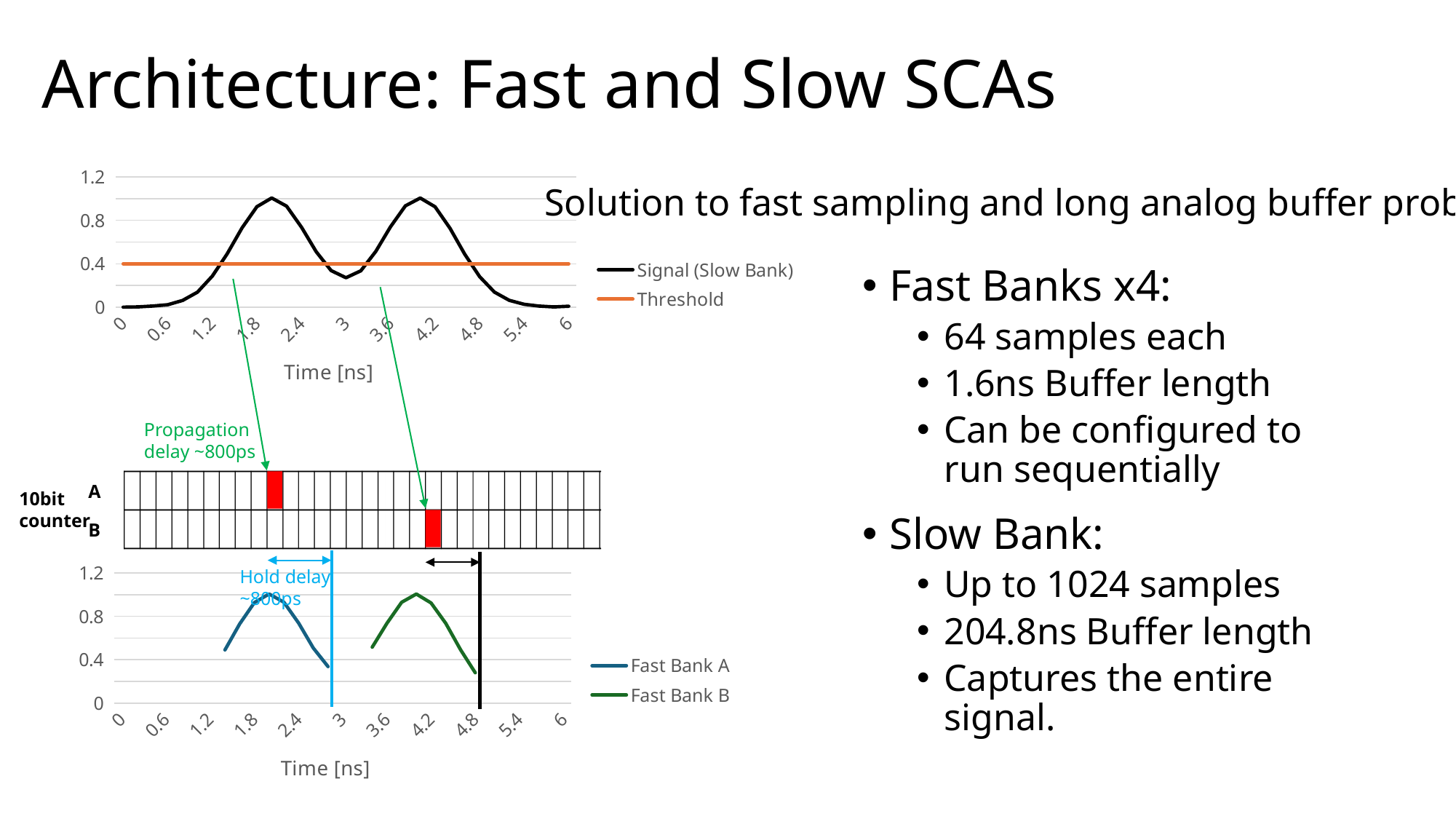
What kind of chart is the top chart on the slide? line chart In the top chart, is the Signal (Slow Bank) value at time 0 greater or less than 0.4? less How many series does the legend of the bottom chart list? 2 In the bottom chart, which series is plotted in green? Fast Bank B In the top chart, does the Signal (Slow Bank) series rise or fall between 1.2 ns and 1.8 ns? rise In the top chart, is the Signal (Slow Bank) value at 6 ns greater or less than 0.4? less In the top chart, is the Signal (Slow Bank) value at 3 ns greater or less than 0.4? less What is the x-axis title of the bottom chart? Time [ns] How many series does the legend of the top chart list? 2 In the top chart, what value does the Threshold line sit at on the y axis? 0.4